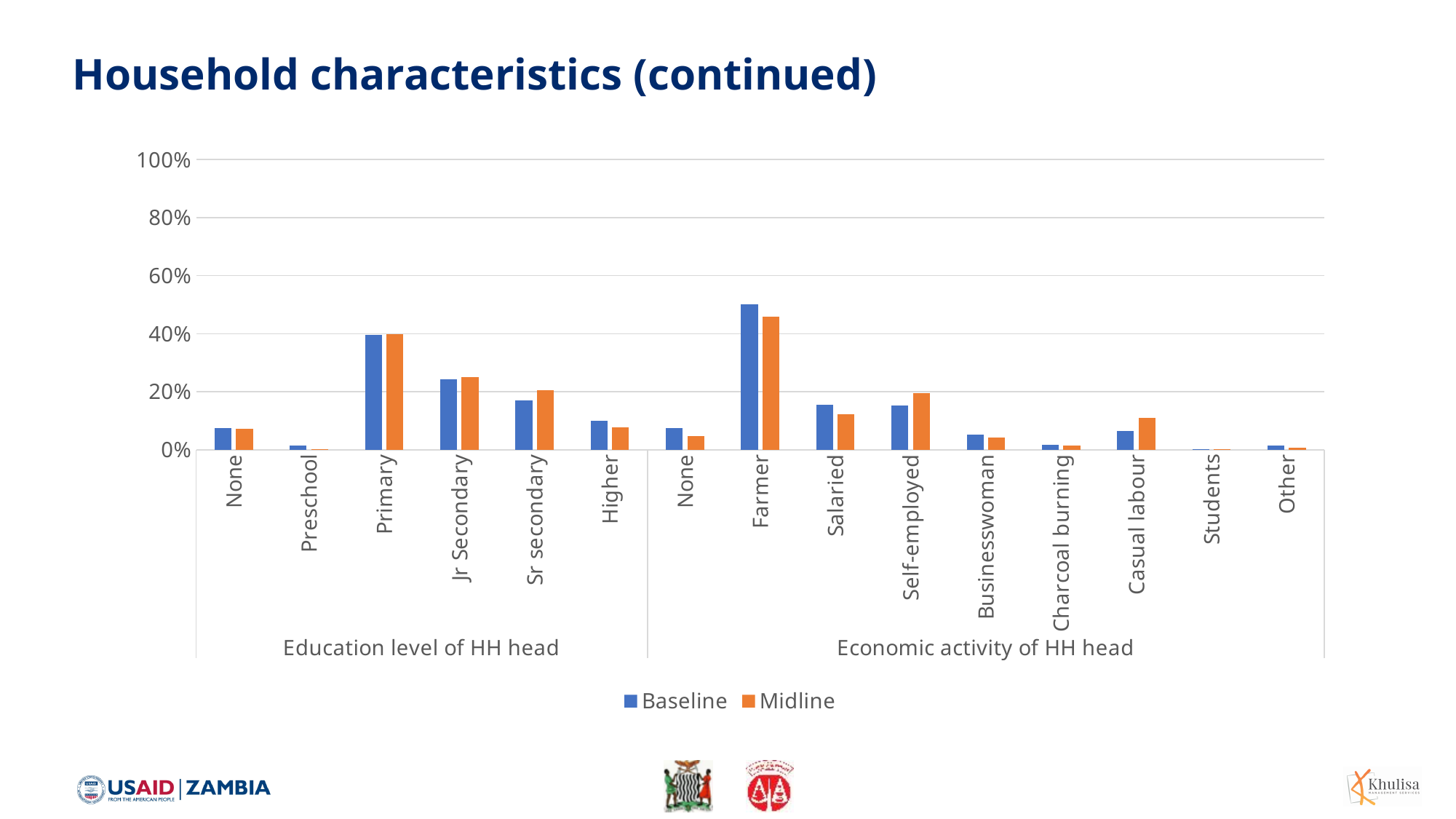
Which education level category has the highest Midline value? Primary Which two series are listed in the legend? Baseline and Midline How many series does the legend list? 2 Which category has the highest Baseline value across the whole chart? Farmer What kind of chart is shown on the slide? Bar chart For Farmer, which is larger: the Baseline or the Midline value? Baseline Is the Baseline value for Farmer greater or less than 40%? greater How many categories are plotted under 'Education level of HH head'? 6 For Casual labour, which is larger: the Baseline or the Midline value? Midline Is the Midline value for Primary greater or less than 60%? less Is the Baseline value for Jr Secondary greater or less than 20%? greater How many categories are plotted under 'Economic activity of HH head'? 9